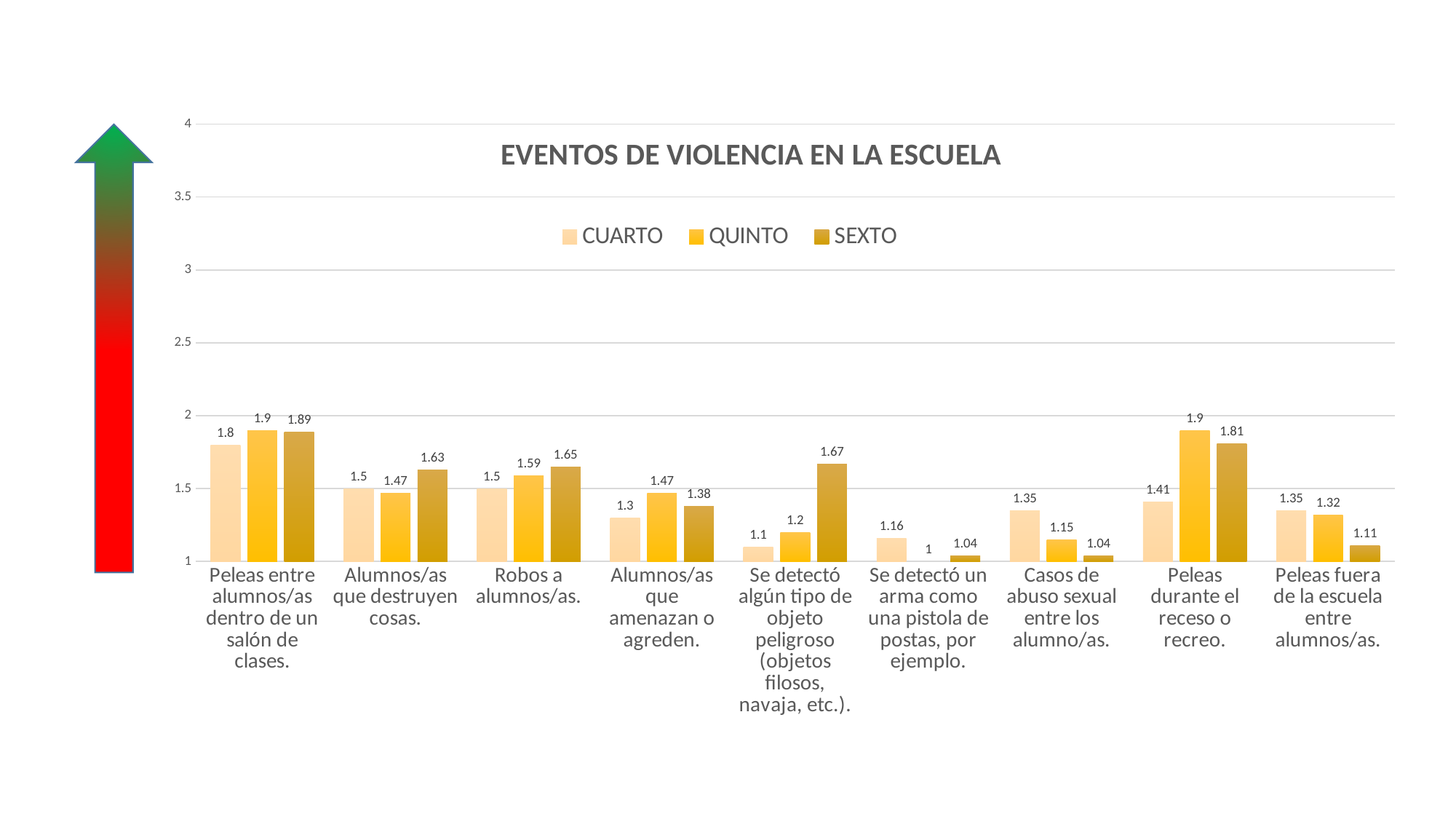
Which category has the lowest QUINTO value? Se detectó un arma como una pistola de postas, por ejemplo. For 'Casos de abuso sexual entre los alumno/as.', which series has the larger value, CUARTO or SEXTO? CUARTO What is the difference between the SEXTO and CUARTO values for 'Se detectó algún tipo de objeto peligroso (objetos filosos, navaja, etc.).'? 0.57 Which category has the highest CUARTO value? Peleas entre alumnos/as dentro de un salón de clases. What type of chart is shown on the slide? bar chart How many categories are shown on the x axis? 9 What is the title of the chart? EVENTOS DE VIOLENCIA EN LA ESCUELA Is the QUINTO value for 'Alumnos/as que destruyen cosas.' greater or less than 2? less What is the QUINTO value for 'Peleas durante el receso o recreo.'? 1.9 What is the CUARTO value for 'Robos a alumnos/as.'? 1.5 What is the SEXTO value for 'Se detectó algún tipo de objeto peligroso (objetos filosos, navaja, etc.).'? 1.67 How many series does the legend list? 3